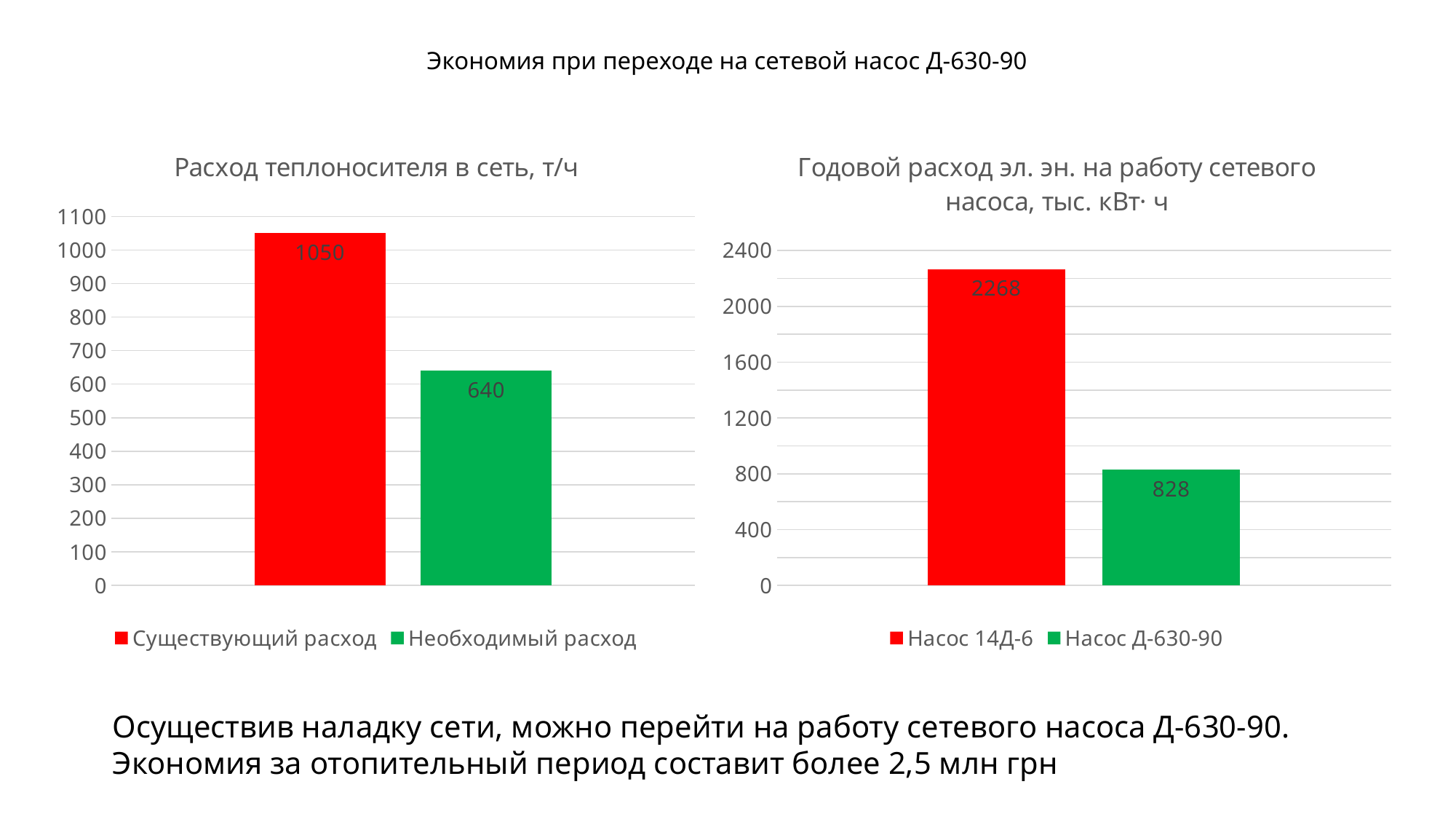
In the chart 'Расход теплоносителя в сеть, т/ч', what is the difference between 'Существующий расход' and 'Необходимый расход'? 410 In the chart 'Годовой расход эл. эн. на работу сетевого насоса, тыс. кВт· ч', what colour is the bar for 'Насос Д-630-90'? green In the chart 'Годовой расход эл. эн. на работу сетевого насоса, тыс. кВт· ч', what is the value for 'Насос 14Д-6'? 2268 What type of chart is the left chart 'Расход теплоносителя в сеть, т/ч'? bar chart In the chart 'Расход теплоносителя в сеть, т/ч', which series has the lower value? Необходимый расход In the chart 'Расход теплоносителя в сеть, т/ч', is the value for 'Необходимый расход' greater or less than 700? less In the chart 'Расход теплоносителя в сеть, т/ч', what is the value for 'Существующий расход'? 1050 In the chart 'Годовой расход эл. эн. на работу сетевого насоса, тыс. кВт· ч', which series has the higher value? Насос 14Д-6 In the chart 'Годовой расход эл. эн. на работу сетевого насоса, тыс. кВт· ч', what is the difference between 'Насос 14Д-6' and 'Насос Д-630-90'? 1440 How many series does the legend of the chart 'Годовой расход эл. эн. на работу сетевого насоса, тыс. кВт· ч' list? 2 In the chart 'Годовой расход эл. эн. на работу сетевого насоса, тыс. кВт· ч', what is the value for 'Насос Д-630-90'? 828 In the chart 'Расход теплоносителя в сеть, т/ч', what is the value for 'Необходимый расход'? 640